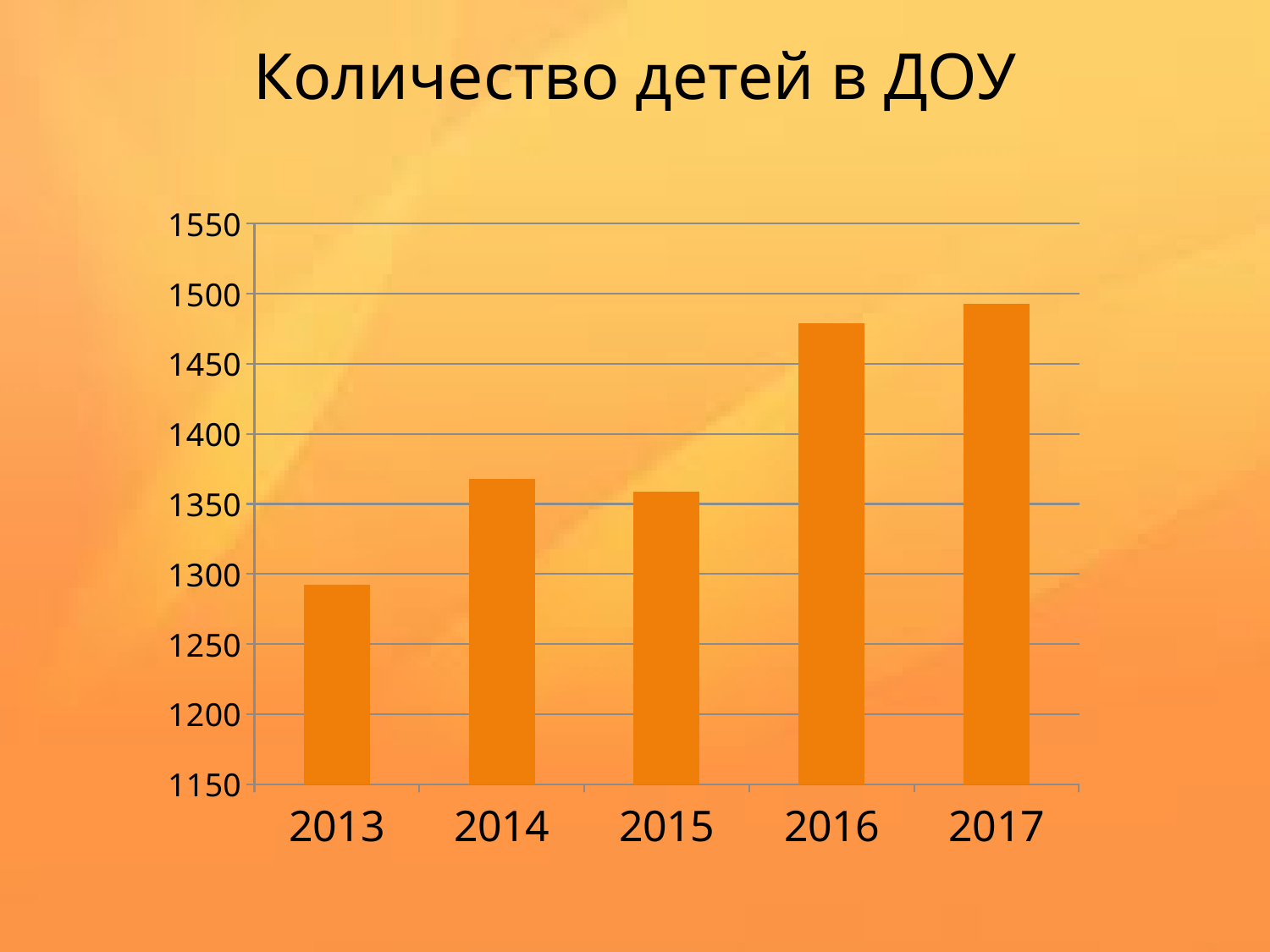
Is the value for 2017 greater or less than 1450? greater What is the title of the chart? Количество детей в ДОУ Which year has the highest bar in the chart? 2017 Which year has the lowest bar in the chart? 2013 What kind of chart is shown on the slide? Bar chart Is the value for 2014 greater or less than 1400? less Which year has the larger value, 2013 or 2016? 2016 Is the value for 2015 greater or less than 1400? less How many years are shown on the x axis of the chart? 5 Do the values generally rise or fall from 2013 to 2017? Rise